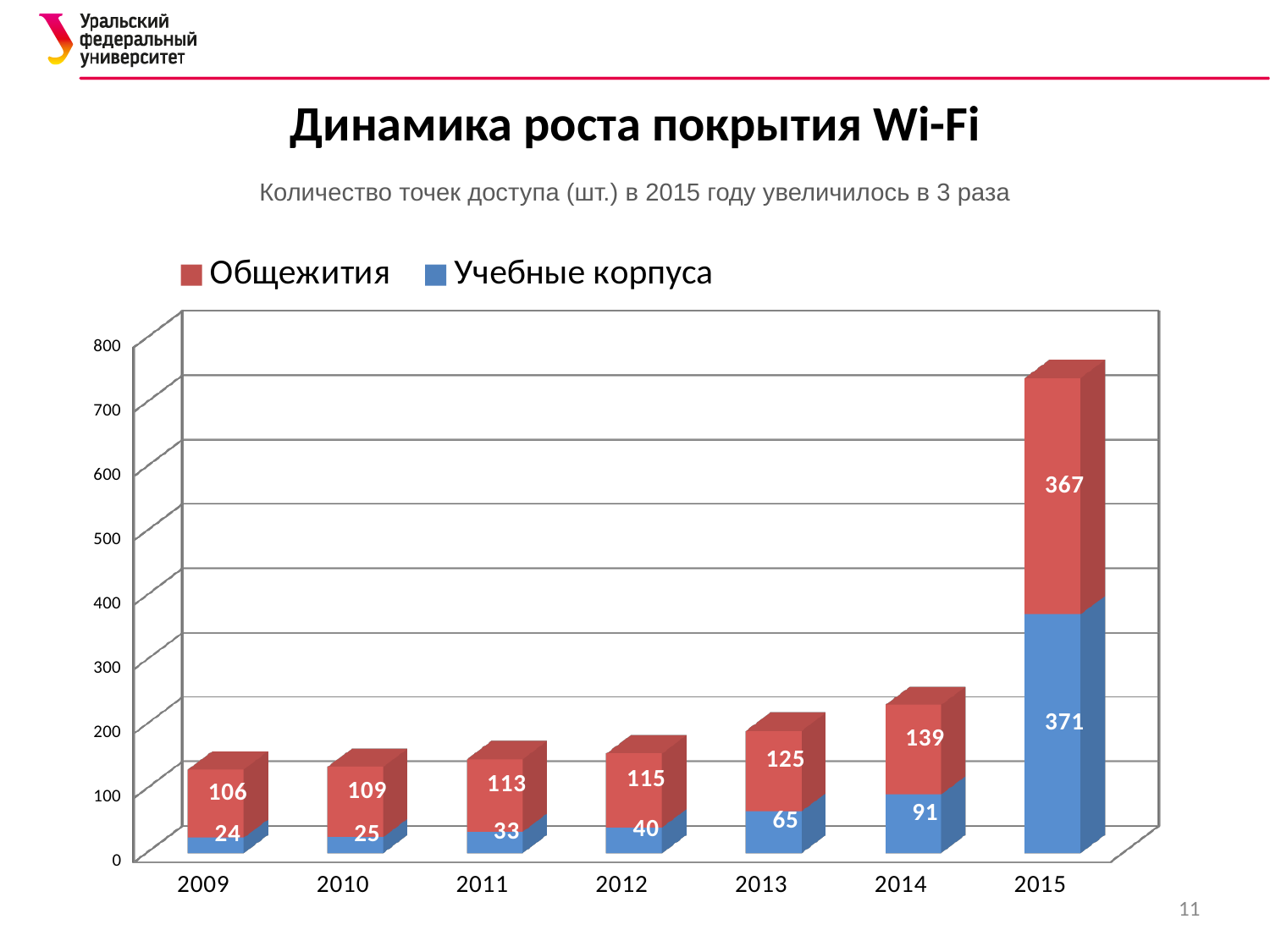
What is the value for Общежития in 2015? 367 What is the value for Учебные корпуса in 2012? 40 Do the Учебные корпуса values rise or fall from 2009 to 2015? rise What is the total of the stacked bar for 2014? 230 How many years are shown on the x axis? 7 What is the difference between the Учебные корпуса values for 2014 and 2013? 26 What is the value for Общежития in 2009? 106 Which year has the lowest value for Учебные корпуса? 2009 How many series does the legend list? 2 Which is larger: Общежития in 2015 or Учебные корпуса in 2015? Учебные корпуса in 2015 What is the total of the stacked bar for 2015? 738 Which year has the highest value for Учебные корпуса? 2015